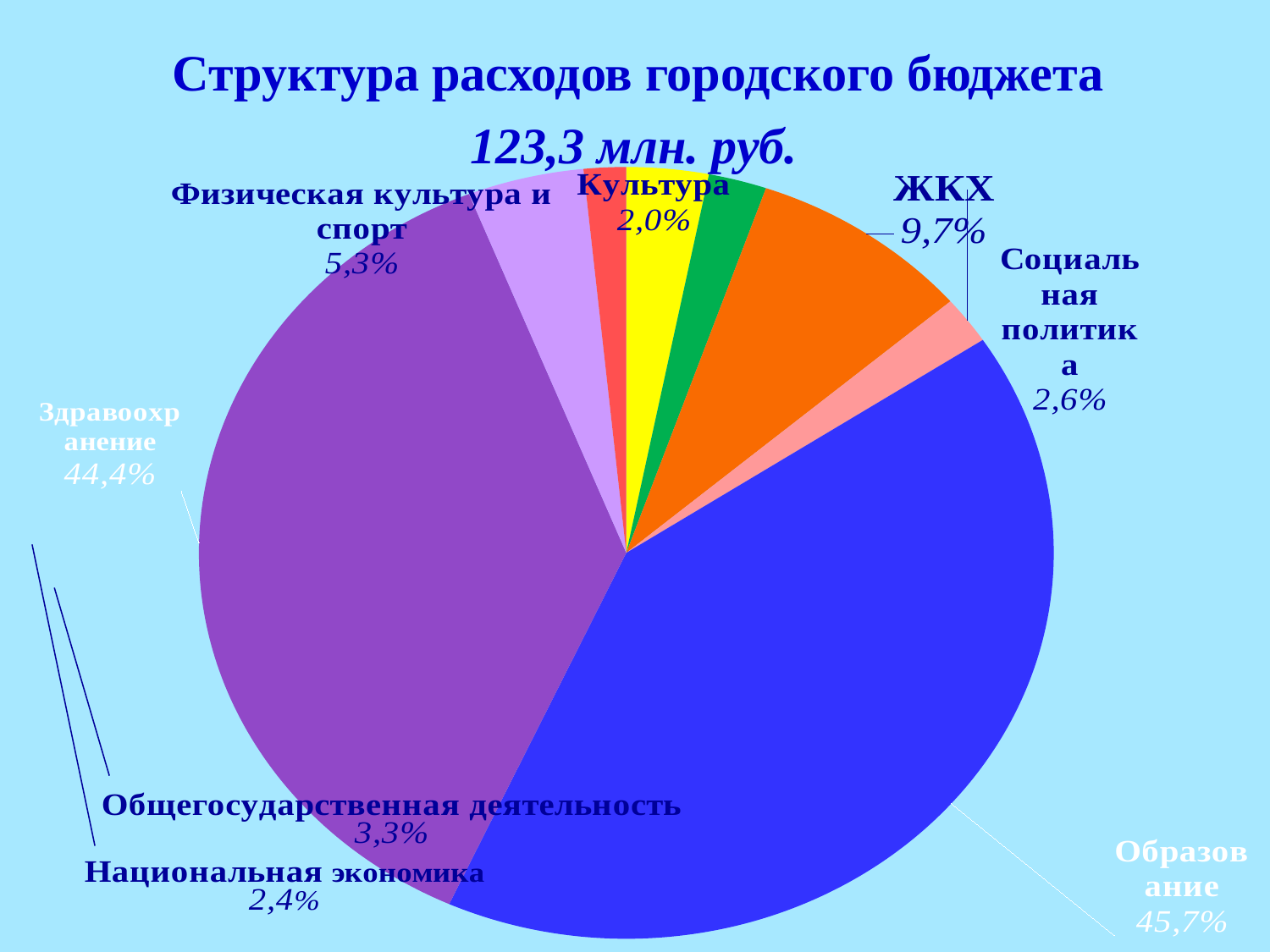
What kind of chart is shown on the slide? pie chart How many categories (slices) does the pie chart have? 8 What percentage is shown for Физическая культура и спорт? 5,3% Which category has the smallest share of the budget? Культура Which is larger, the share for Социальная политика or the share for Общегосударственная деятельность? Общегосударственная деятельность What share of the budget goes to Здравоохранение? 44,4% What is the title of the chart? Структура расходов городского бюджета 123,3 млн. руб. What percentage is shown for Национальная экономика? 2,4% What percentage is shown for ЖКХ? 9,7% What share of the budget goes to Образование? 45,7% Which category has the largest share of the budget? Образование What is the difference between the shares of Образование and Здравоохранение? 1,3%